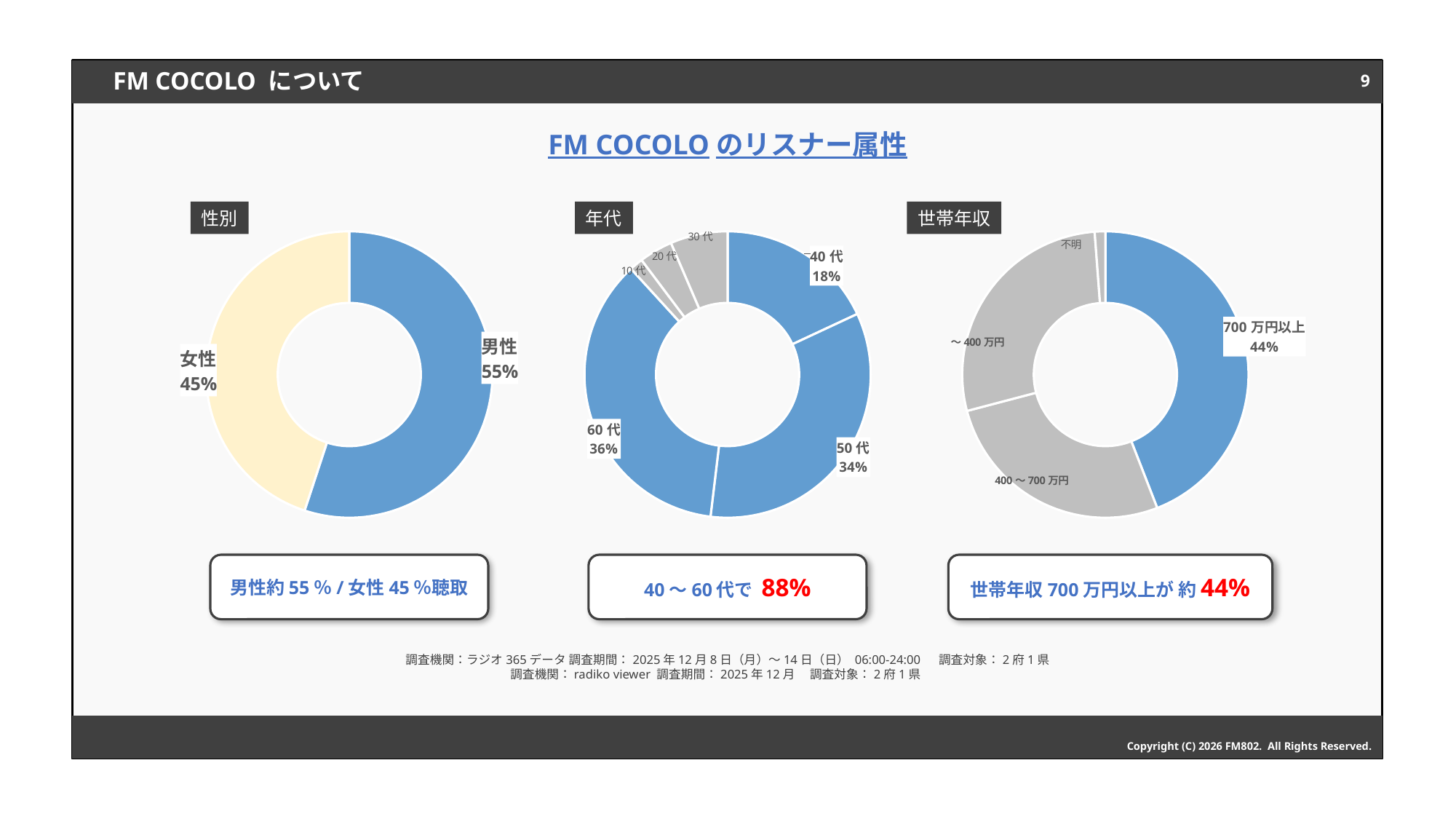
In the 年代 chart, what share of listeners is 50代? 34% In the 性別 chart, what share of listeners is 男性? 55% In the 性別 chart, what is the difference in percentage points between 男性 and 女性? 10 In the 年代 chart, what share of listeners is 40代? 18% In the 年代 chart, what is the combined share of 40代, 50代 and 60代? 88% In the 年代 chart, what share of listeners is 60代? 36% In the 年代 chart, how many age categories are shown? 6 In the 性別 chart, what share of listeners is 女性? 45% What type of chart is used for the 性別 data? Donut (pie) chart In the 性別 chart, which category has the larger share, 男性 or 女性? 男性 In the 世帯年収 chart, what share of listeners has a household income of 700万円以上? 44% In the 世帯年収 chart, how many income categories are shown? 4